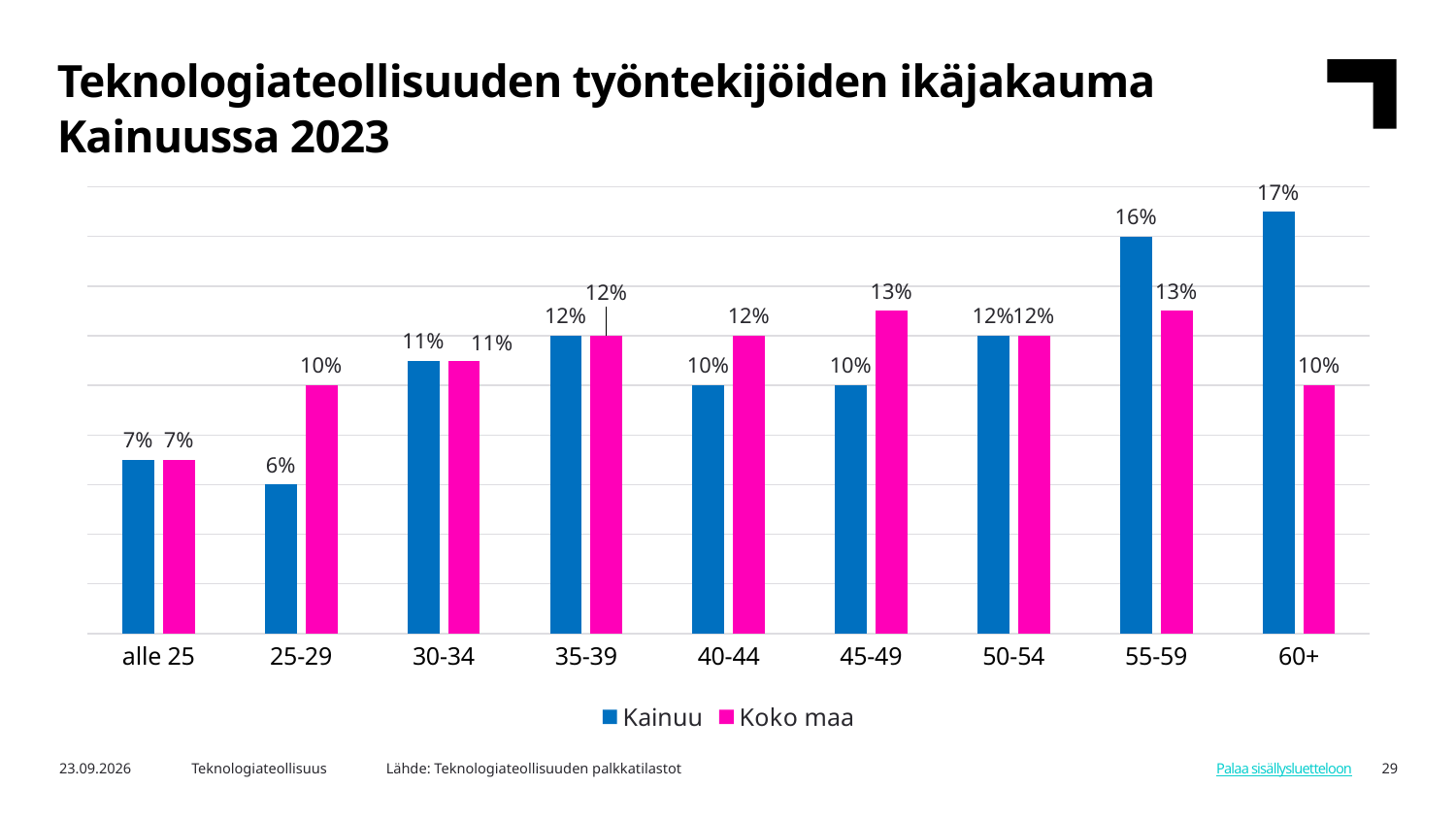
In the 55-59 age group, which series has the larger value, Kainuu or Koko maa? Kainuu What is the value for Koko maa in the 45-49 age group? 13% Which colour represents the Koko maa series? Pink Which age group has the highest value for Kainuu? 60+ What is the value for Kainuu in the 25-29 age group? 6% How many series does the legend list? 2 In the 25-29 age group, which series has the larger value, Kainuu or Koko maa? Koko maa What kind of chart is shown on the slide? Bar chart Which age group has the lowest value for Kainuu? 25-29 How many age groups are shown on the x axis? 9 What is the value for Kainuu in the 60+ age group? 17% What is the difference between the Kainuu and Koko maa values in the 60+ age group? 7 percentage points